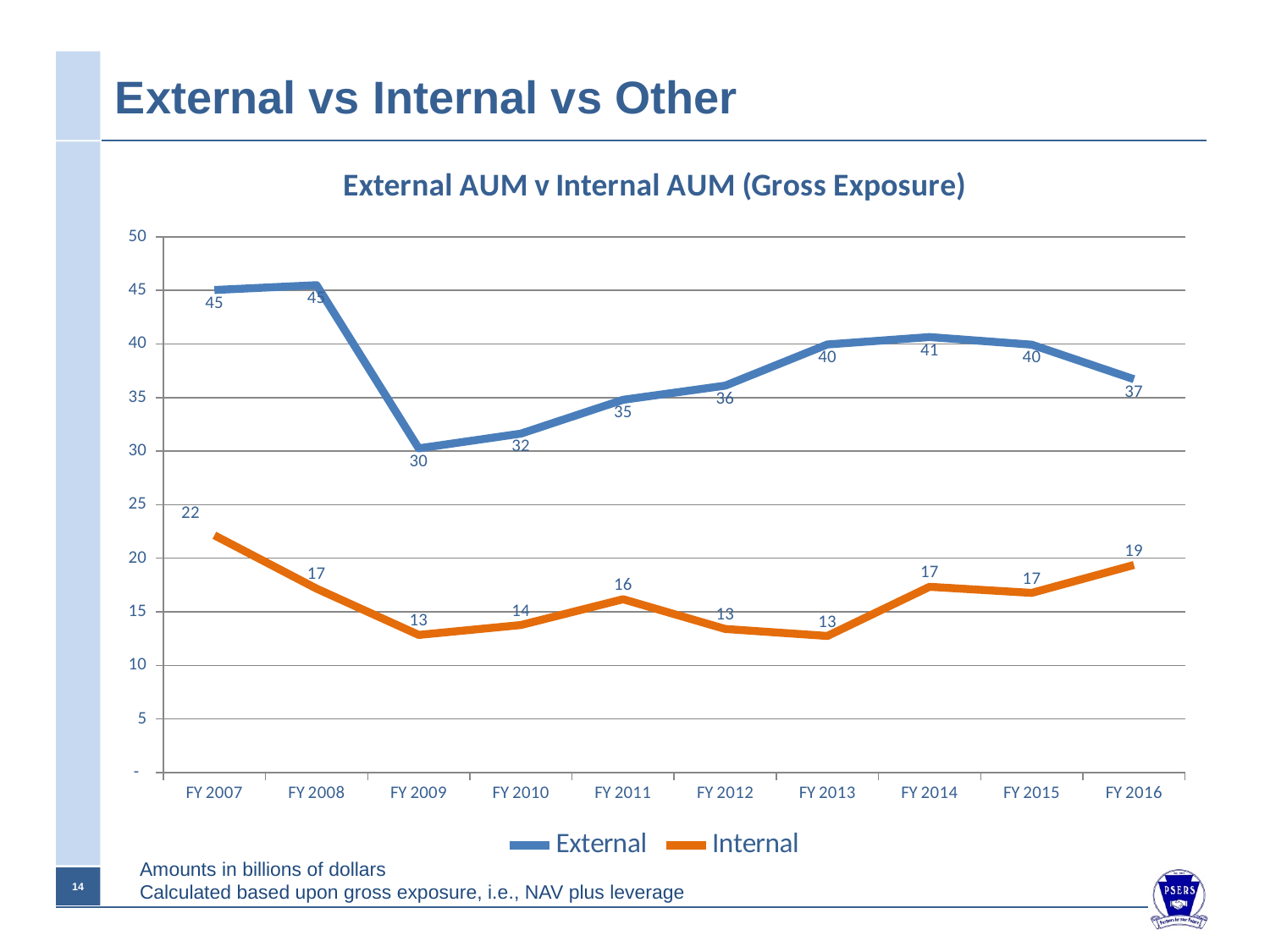
What is the External value for FY 2009? 30 What is the External value for FY 2014? 41 How many series does the legend list? 2 What is the Internal value for FY 2007? 22 What is the difference between the External and Internal values in FY 2016? 18 What type of chart is shown on the slide? line chart In which fiscal year is the External value lowest? FY 2009 What is the Internal value for FY 2016? 19 Which is larger in FY 2011, the External value or the Internal value? External How many fiscal years are shown on the x axis? 10 In which fiscal year is the Internal value highest? FY 2007